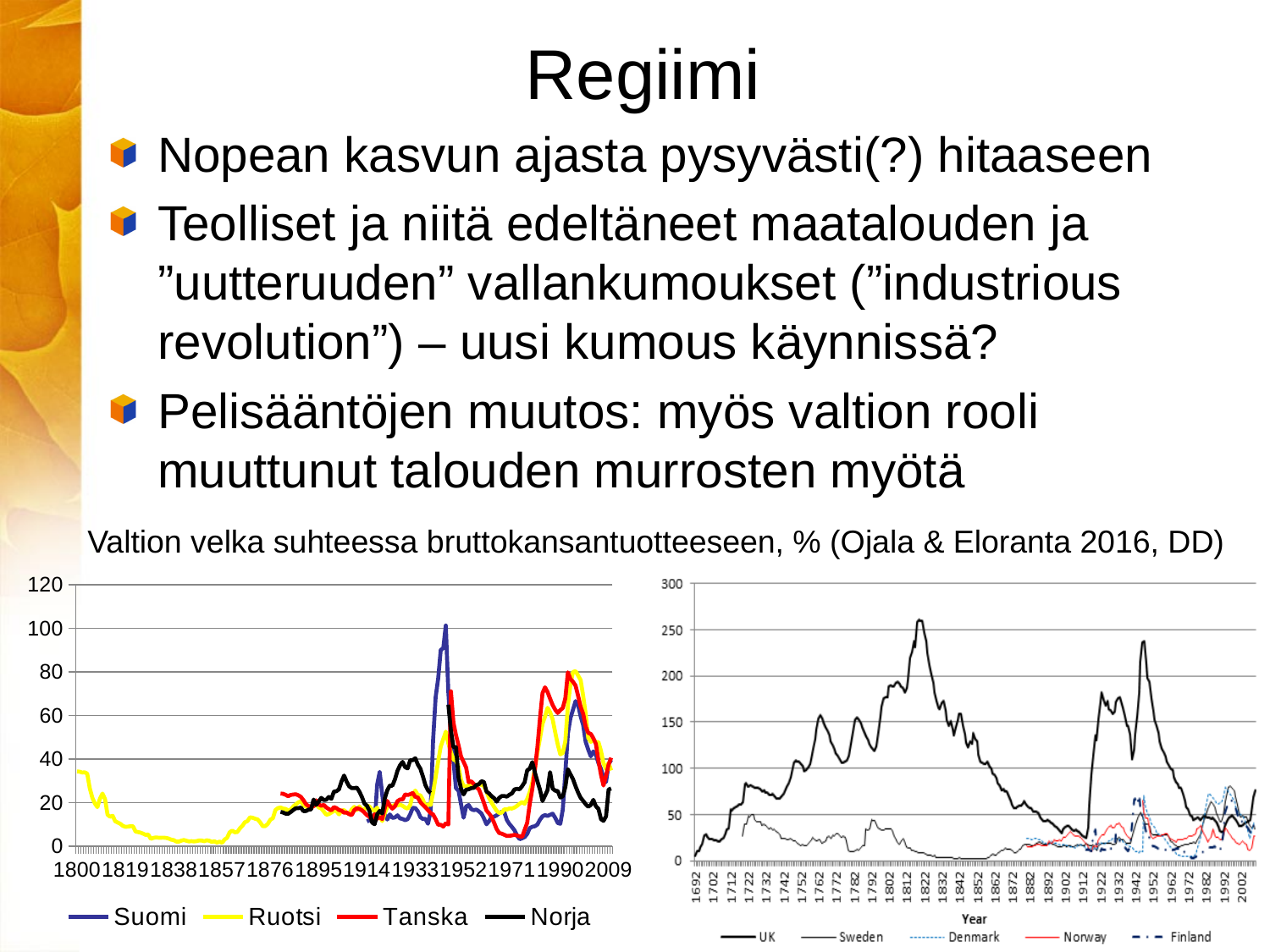
In the left chart, which series reaches the highest peak value? Suomi How many series does the legend of the right chart list? 5 In the right chart, is the peak value for Sweden greater or less than 100? less In the left chart, is the value for Ruotsi at 1800 greater or less than 20? greater What kind of chart is the left chart on the slide? line chart In the left chart, is the peak value for Suomi greater or less than 80? greater In the right chart, which series reaches the highest peak value? UK What kind of chart is the right chart on the slide? line chart What is the title shown above the two charts? Valtion velka suhteessa bruttokansantuotteeseen, % (Ojala & Eloranta 2016, DD) In the left chart, which series is drawn in yellow? Ruotsi How many series does the legend of the left chart list? 4